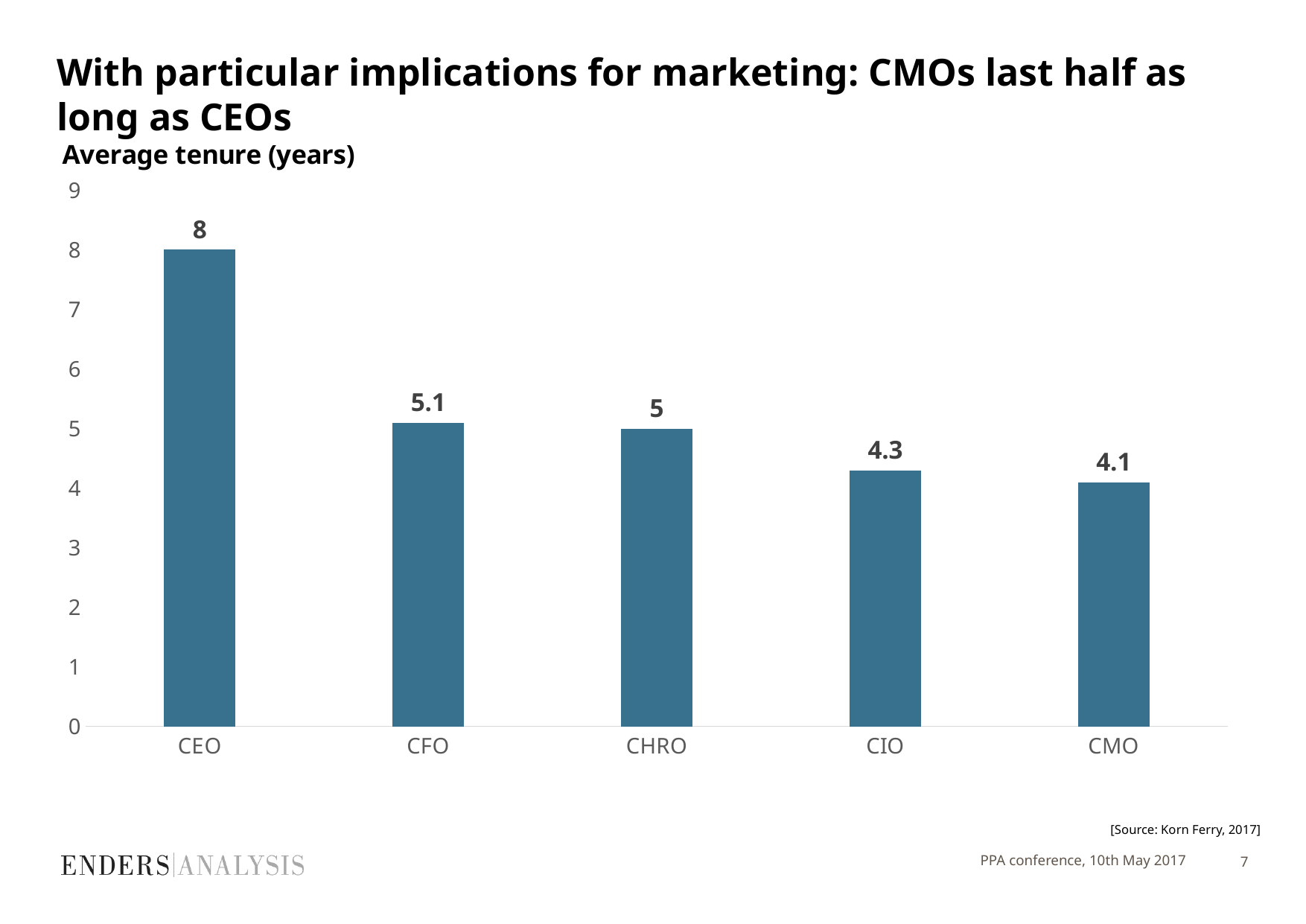
What is the average tenure in years for the CFO? 5.1 What is the average tenure in years for the CIO? 4.3 Which role has the highest average tenure? CEO What is the difference in average tenure between the CFO and the CHRO? 0.1 What kind of chart is shown on the slide? Bar chart What is the average tenure in years for the CEO? 8 What is the title of the chart? Average tenure (years) How many roles are shown on the chart? 5 Which has a longer average tenure, the CHRO or the CIO? CHRO What is the difference in average tenure between the CEO and the CMO? 3.9 What is the average tenure in years for the CMO? 4.1 Which role has the lowest average tenure? CMO